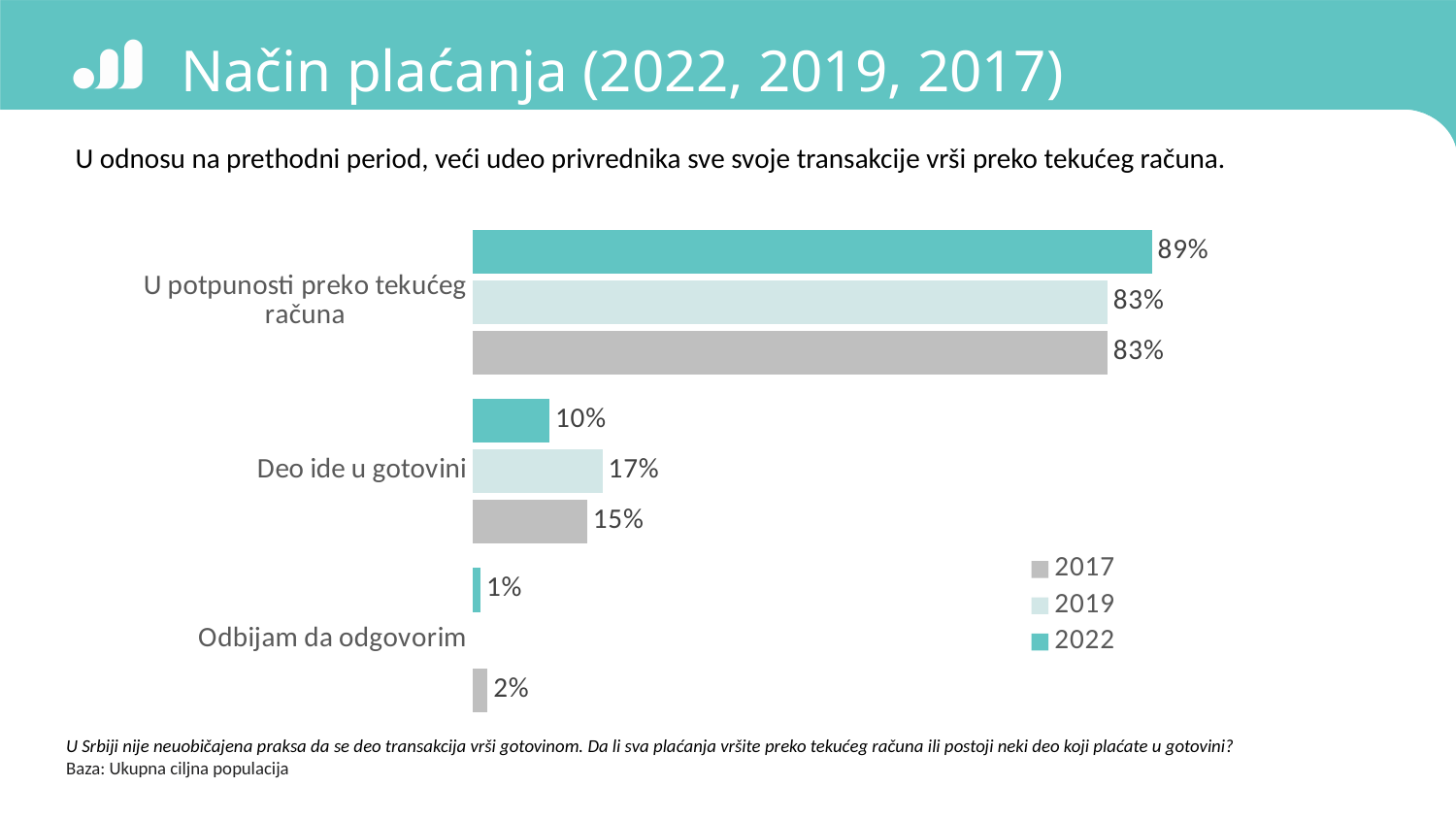
What is the value for 2019 in the category "Deo ide u gotovini"? 17% What is the value for 2017 in the category "Deo ide u gotovini"? 15% What is the value for 2022 in the category "U potpunosti preko tekućeg računa"? 89% What is the value for 2017 in the category "Odbijam da odgovorim"? 2% What is the value for 2022 in the category "Odbijam da odgovorim"? 1% Which category has the highest value for the 2022 series? U potpunosti preko tekućeg računa Which year does the grey colour represent in the legend? 2017 For "Deo ide u gotovini", which is larger: the 2019 value or the 2022 value? 2019 What kind of chart is shown on the slide? Bar chart What is the difference between the 2022 and 2019 values for "U potpunosti preko tekućeg računa"? 6% How many series does the legend list? 3 Which category has the lowest value for the 2017 series? Odbijam da odgovorim